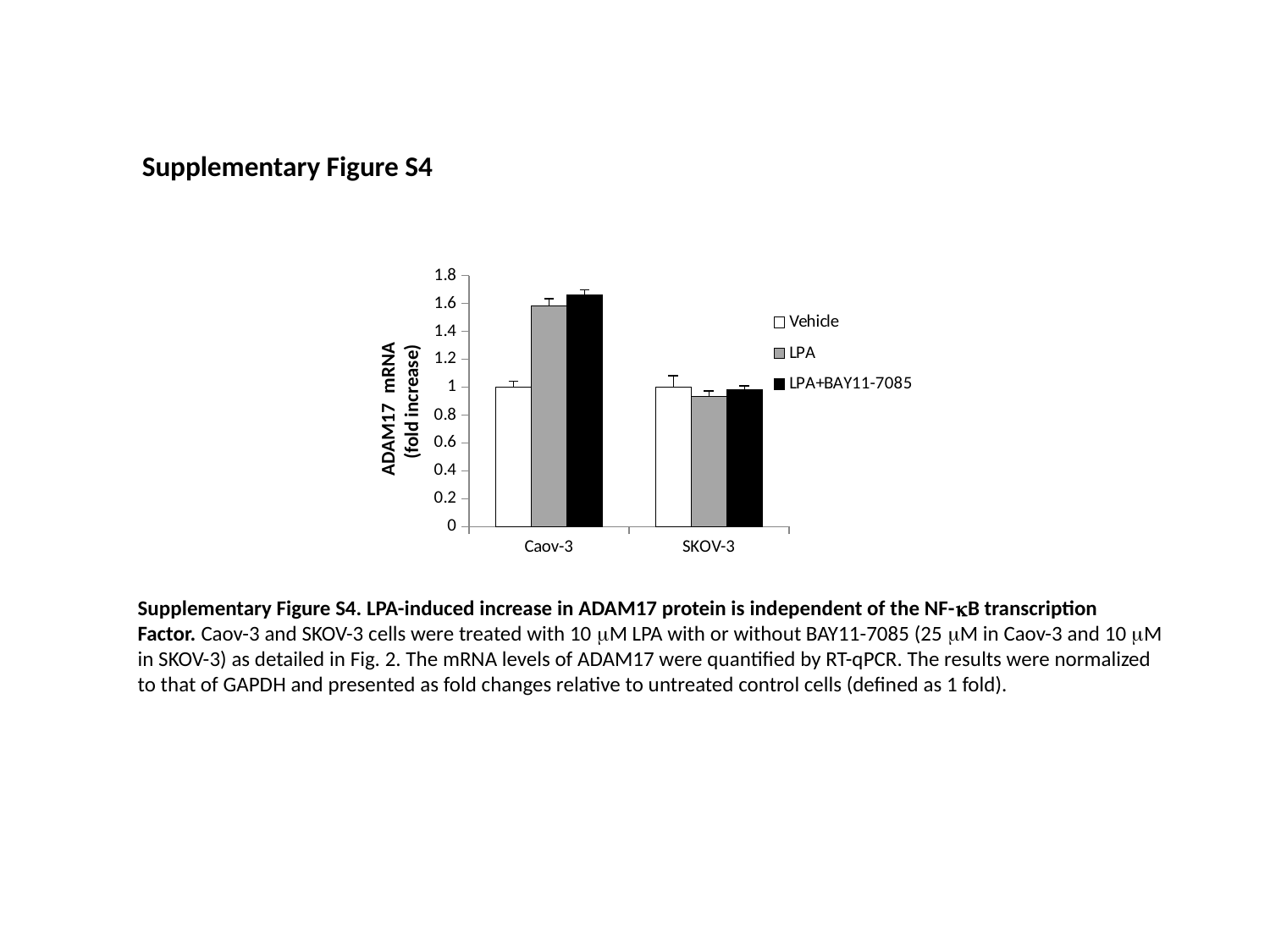
What is the value for Vehicle in Caov-3? 1 What kind of chart is shown on the slide? bar chart How many categories are shown on the x axis of the chart? 2 Which series is shown with black bars in the chart? LPA+BAY11-7085 Is the value for LPA in SKOV-3 greater or less than 1.2? less What is the value for Vehicle in SKOV-3? 1 Is the value for LPA+BAY11-7085 in Caov-3 greater or less than 1.4? greater How many series does the chart's legend list? 3 Which is larger in Caov-3, the Vehicle value or the LPA value? LPA Is the value for LPA in Caov-3 greater or less than 1.4? greater What is the label of the y axis of the chart? ADAM17 mRNA (fold increase) Which is larger, the LPA value for Caov-3 or the LPA value for SKOV-3? Caov-3